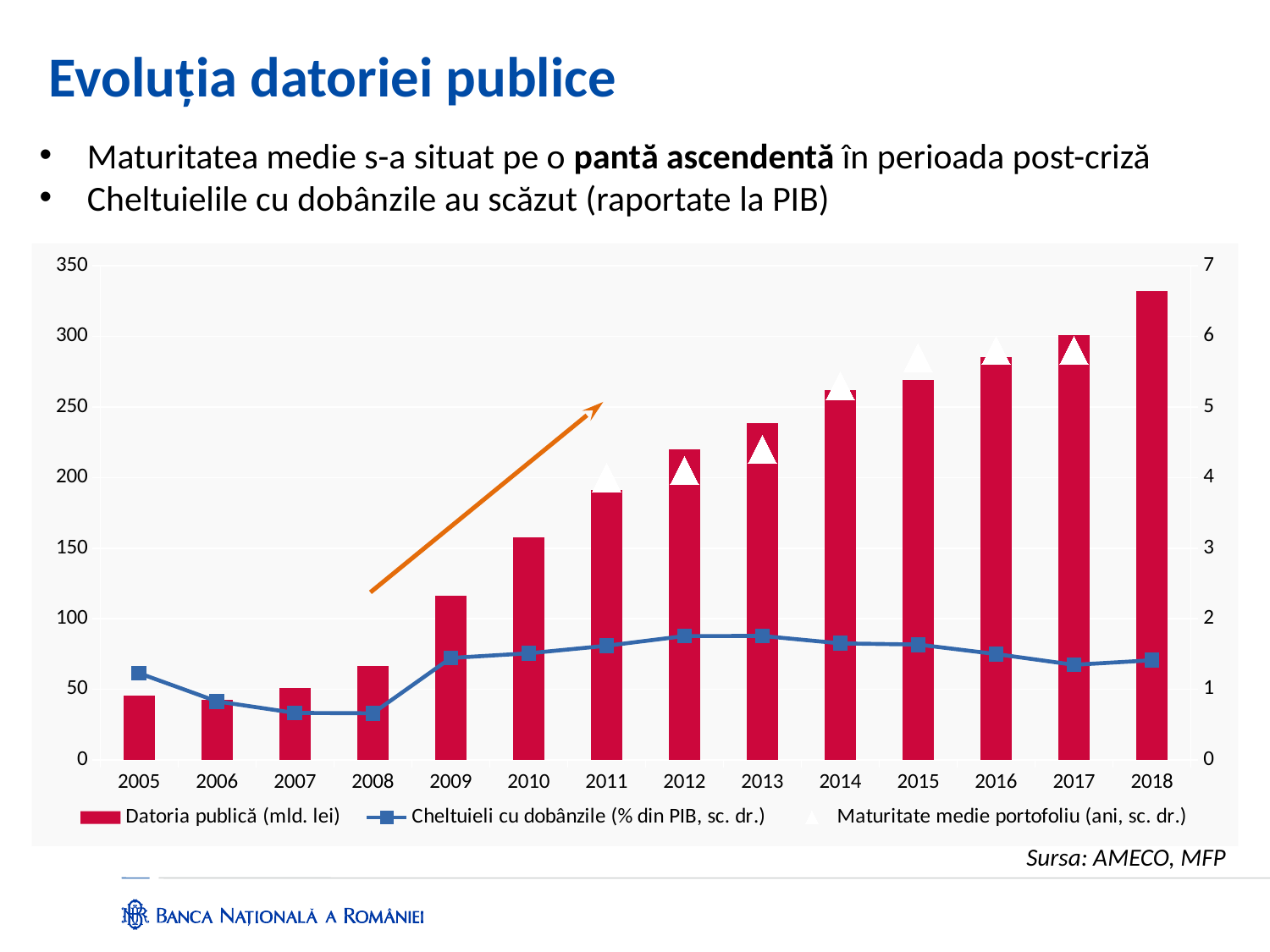
Does Datoria publică (mld. lei) generally rise or fall from 2008 to 2018? Rise Is the value of Datoria publică (mld. lei) for 2014 greater or less than 250? greater How many years are shown on the x axis of the chart? 14 How many series does the chart legend list? 3 Is the value of Datoria publică (mld. lei) for 2018 greater or less than 300? greater Is the value of Cheltuieli cu dobânzile (% din PIB) for 2007 greater or less than 1 on the right axis? less Which year has the highest value for Datoria publică (mld. lei)? 2018 Which year has the higher value for Cheltuieli cu dobânzile (% din PIB), 2012 or 2007? 2012 What kind of chart is shown on the slide? Combined bar and line chart Which is larger, Datoria publică in 2017 or in 2012? 2017